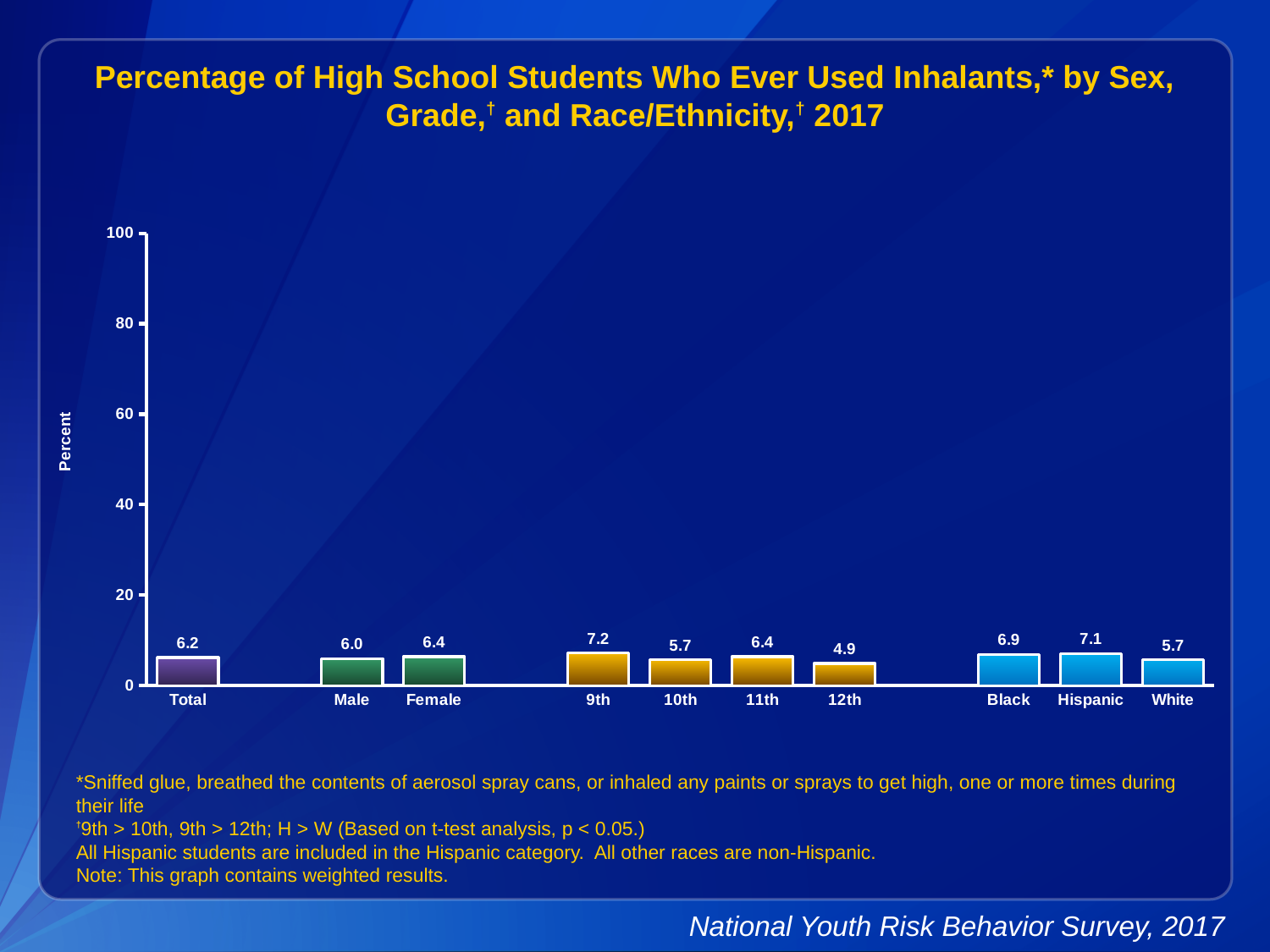
What is the value for Hispanic? 7.1 What is the value for 12th grade? 4.9 What is the difference between the values for 9th and 12th grade? 2.3 How many categories are shown on the x axis? 10 Which category has the highest value? 9th Which is larger, the value for Male or the value for Female? Female What is the value for Total? 6.2 Is the value for Black greater or less than 20? less What kind of chart is shown? bar chart Which category has the lowest value? 12th What is the value for Female? 6.4 What is the label of the y axis? Percent